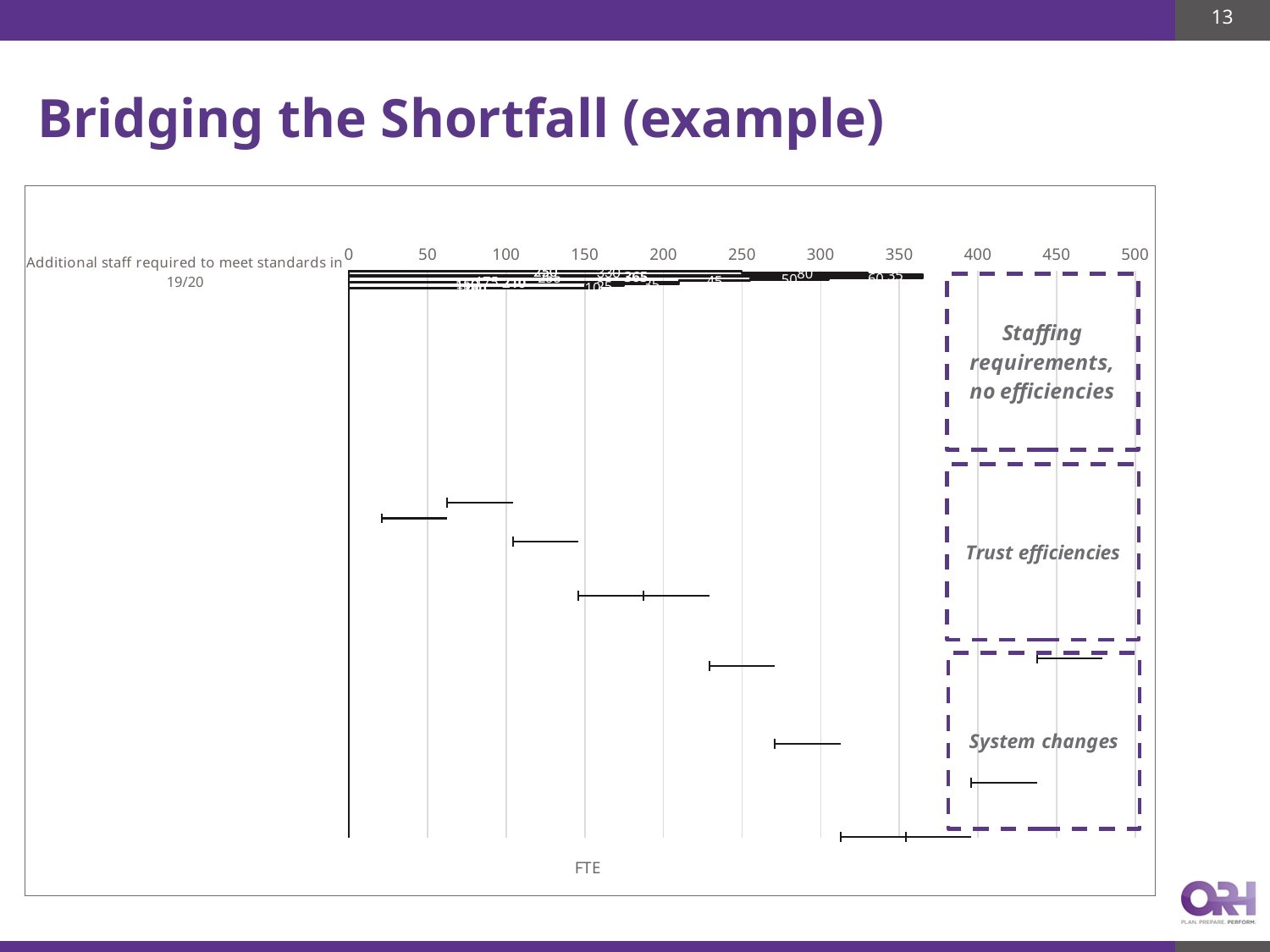
How many categories are listed on the y axis of the chart? 1 What is the category label shown on the y axis of the chart? Additional staff required to meet standards in 19/20 Is the right end of the longest bar in the chart greater or less than 300 on the x axis? greater Is the right end of the longest bar in the chart greater or less than 400 on the x axis? less What is the highest tick value shown on the x axis of the chart? 500 What is the title of the x axis of the chart? FTE What kind of chart is shown on the slide? bar chart